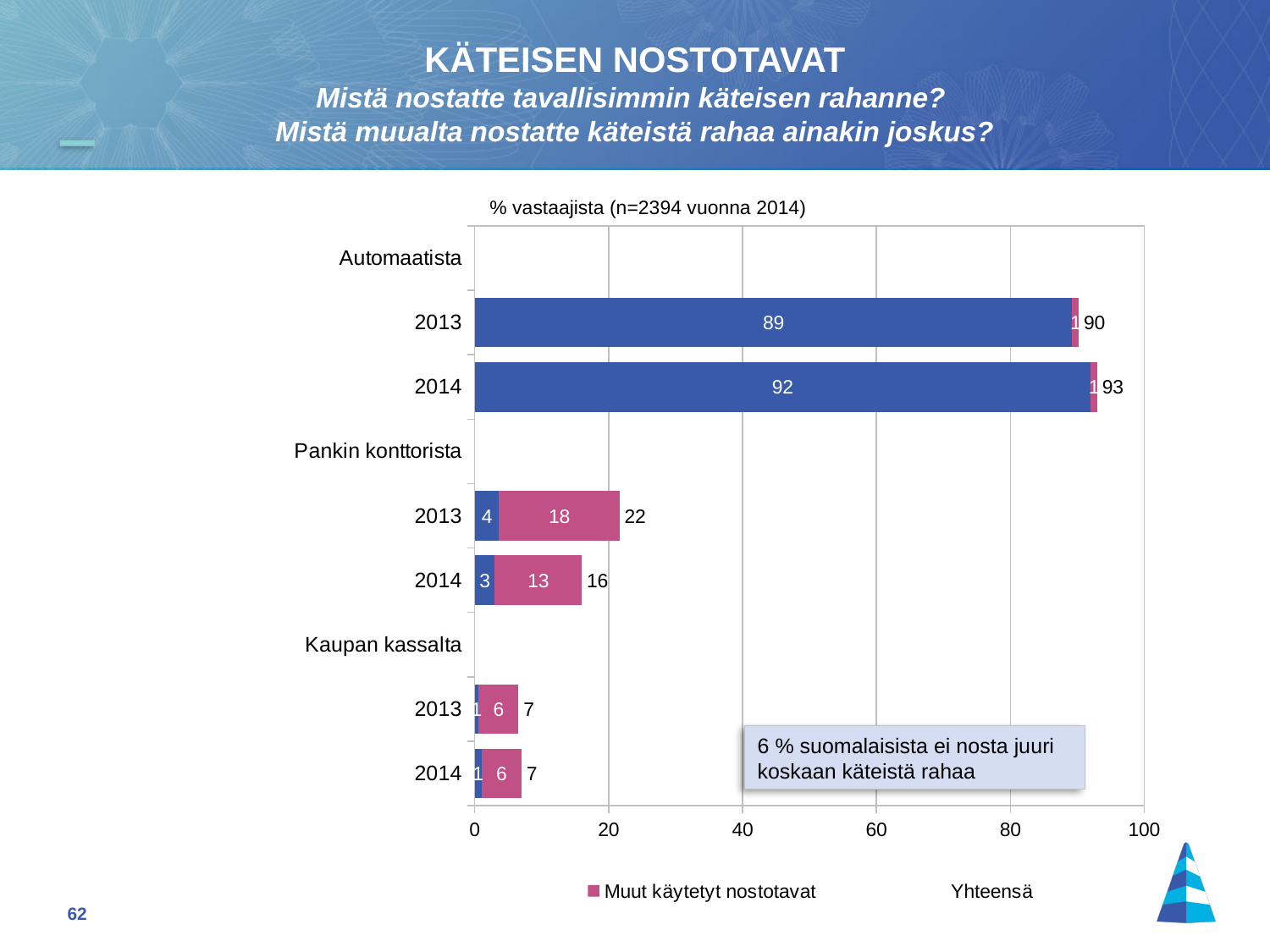
What kind of chart is shown on the slide? bar chart Is the total for Automaatista in 2014 larger or smaller than in 2013? larger What is the value of the 'Muut käytetyt nostotavat' segment for Pankin konttorista in 2013? 18 What is the total value shown for Automaatista in 2013? 90 What is the difference between the total for Pankin konttorista in 2013 and in 2014? 6 Which category has the highest total value in 2014? Automaatista What is the total value shown for Kaupan kassalta in 2014? 7 Which category has the lowest total value in 2013? Kaupan kassalta What is the total value shown for Automaatista in 2014? 93 Is the total value for Pankin konttorista in 2013 greater or less than 20? greater What is the value of the 'Muut käytetyt nostotavat' segment for Pankin konttorista in 2014? 13 What is the subtitle above the chart describing the respondents? % vastaajista (n=2394 vuonna 2014)